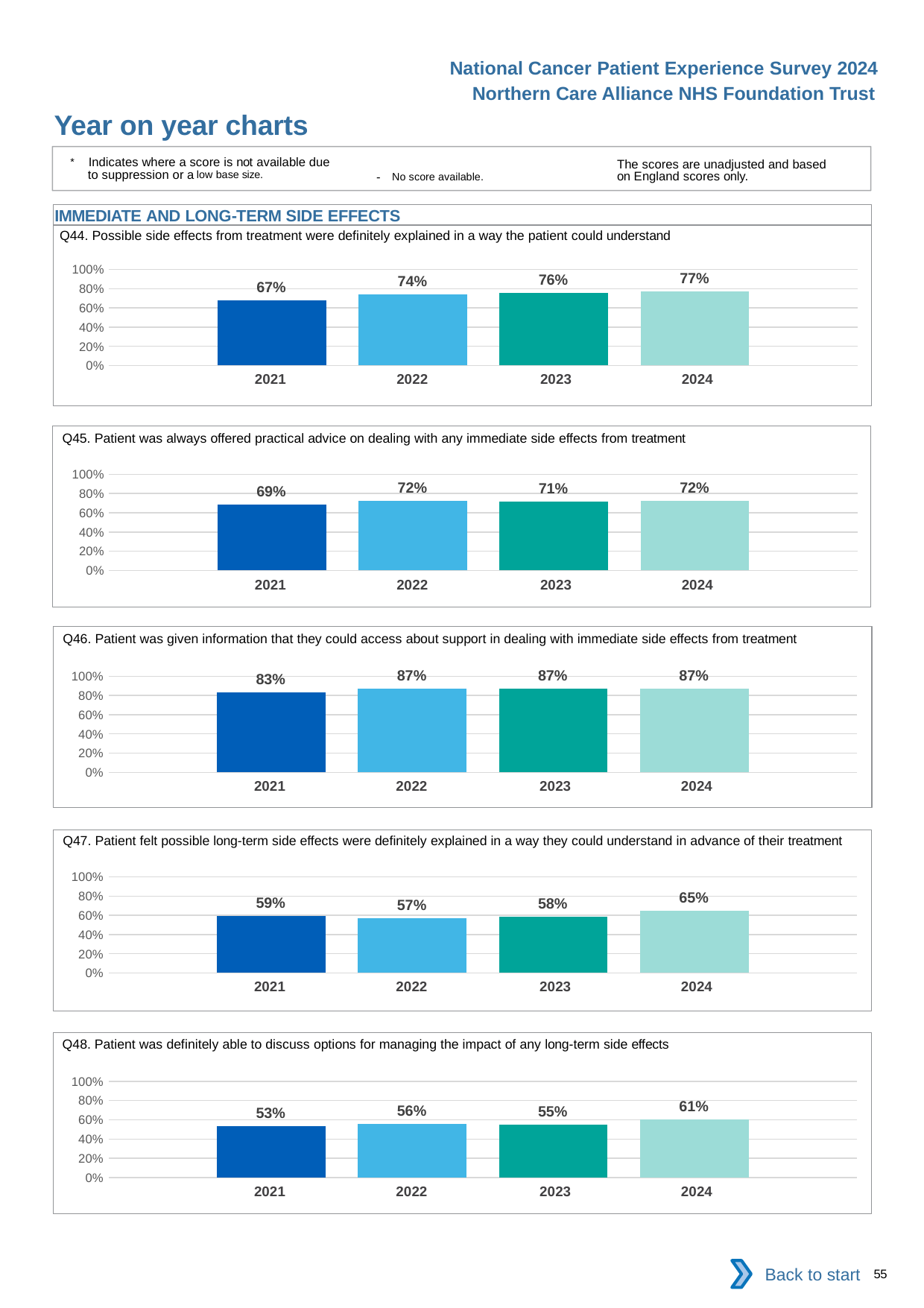
In the Q47 chart, what is the difference between the 2024 and 2023 values? 7% In the Q47 chart, which year has the highest value? 2024 In the Q44 chart, which year has the lowest value? 2021 In the Q44 chart, do the values rise or fall from 2021 to 2024? Rise In the Q45 chart, what is the difference between the 2022 and 2021 values? 3% In the Q48 chart, is the value for 2021 greater or less than 60%? less In the Q44 chart, what is the value for 2024? 77% In the Q46 chart, what is the value for 2021? 83% In the Q45 chart, what is the value for 2023? 71% What kind of chart is the Q48 chart? Bar chart In the Q46 chart, how many years are plotted? 4 In the Q48 chart, which is larger, the value for 2022 or the value for 2023? 2022